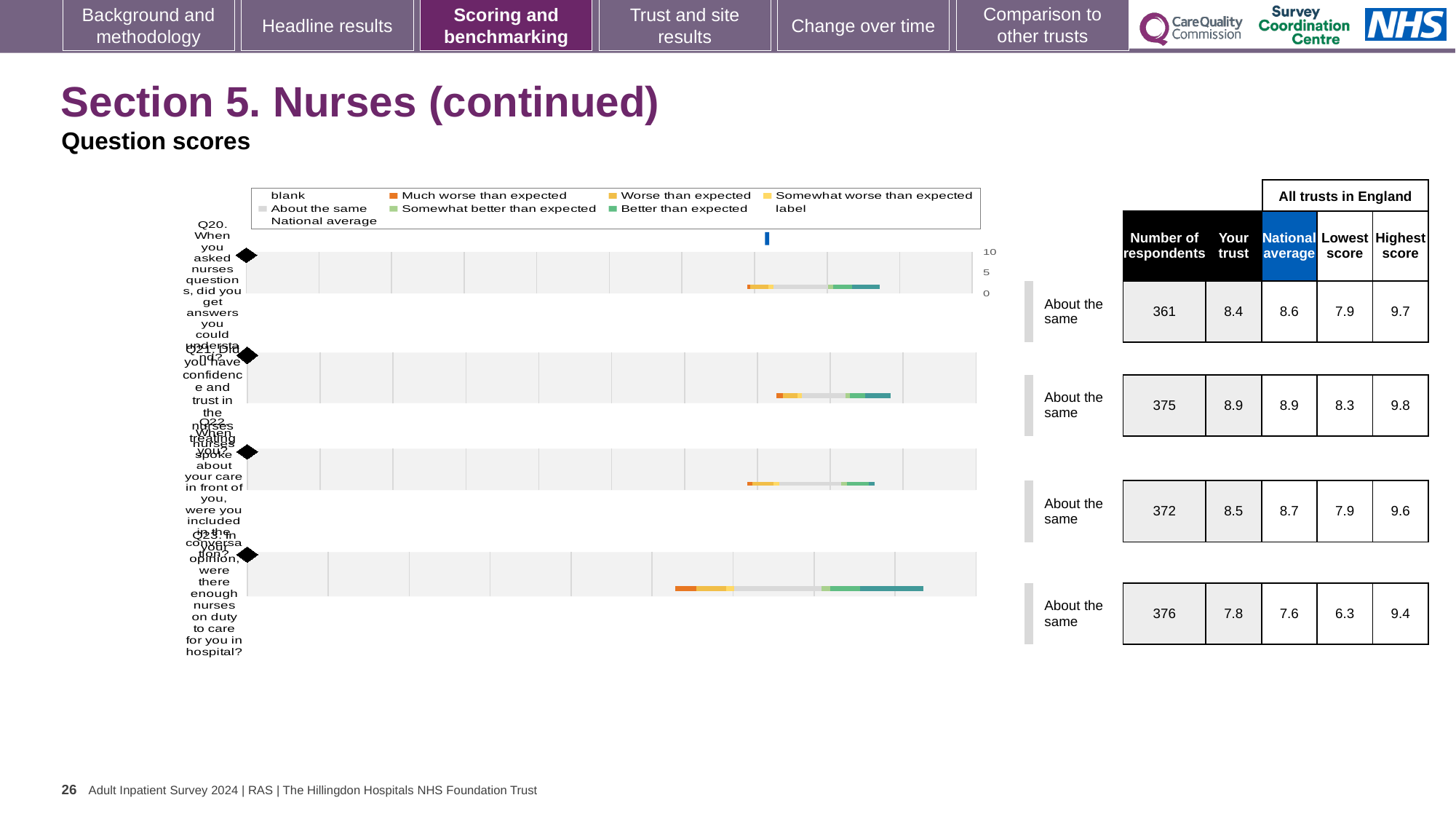
What is the 'Your trust' score for Q23 (enough nurses on duty)? 7.8 What kind of chart is shown on the slide? bar chart What is the number of respondents for Q21 (confidence and trust in the nurses)? 375 What is the highest score among all trusts in England for Q21? 9.8 For Q22, which is larger: the 'Your trust' score or the national average? National average What is the national average for Q22? 8.7 Which question has the highest 'Your trust' score? Q21 Is the 'Your trust' marker for Q23 greater or less than 5 on the axis? greater What is the difference between the national average and the 'Your trust' score for Q20? 0.2 How many questions (Q20 to Q23) are plotted in the chart? 4 Which question has the lowest 'Your trust' score? Q23 What benchmark category is shown for Q23? About the same